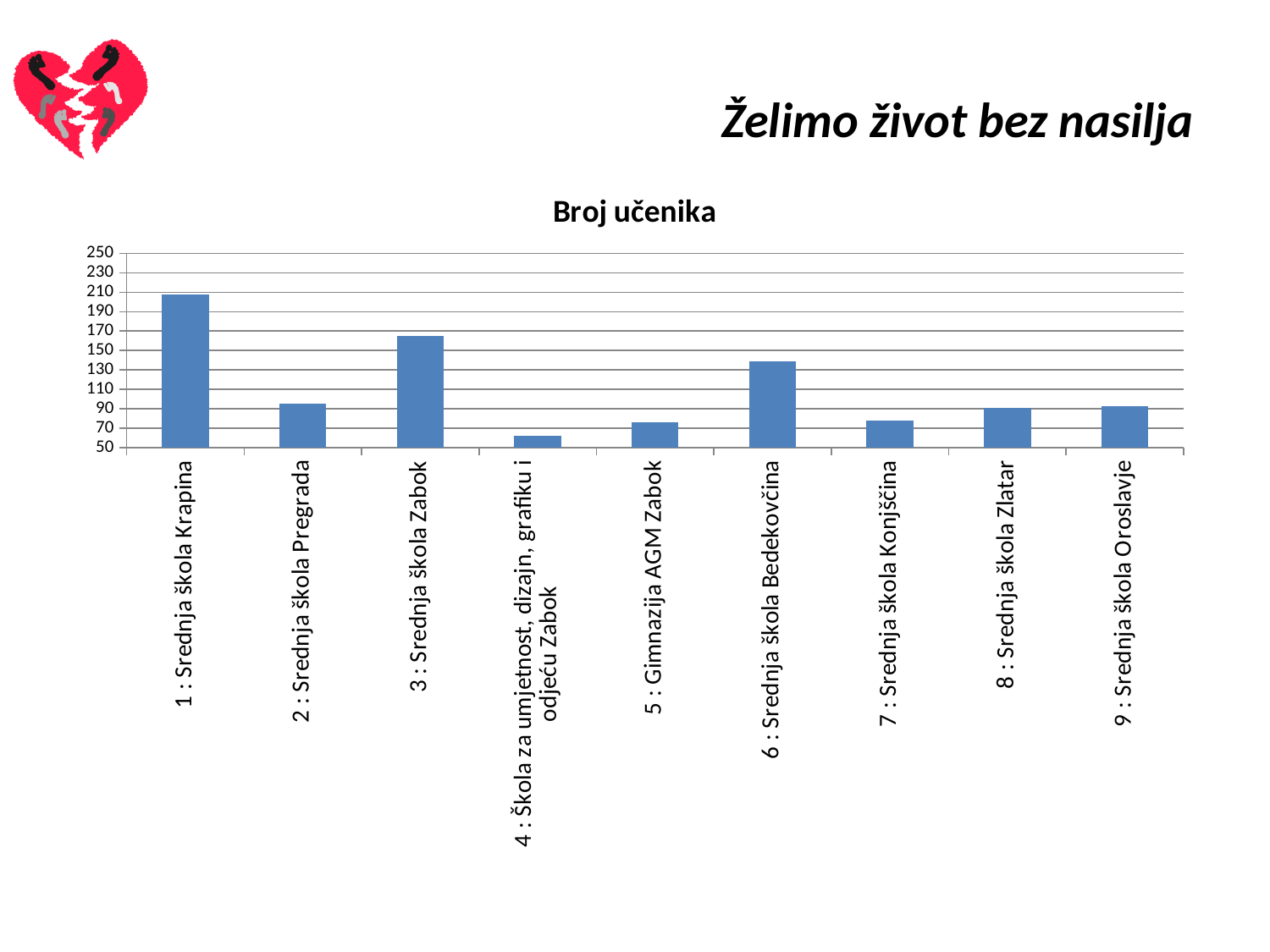
Is the value for 1 : Srednja škola Krapina greater or less than 190? greater What is the title of the chart? Broj učenika What kind of chart is shown on the slide? bar chart Is the value for 6 : Srednja škola Bedekovčina greater or less than 110? greater How many schools (categories) are shown on the x axis of the chart? 9 Is the value for 5 : Gimnazija AGM Zabok greater or less than 90? less Which school has the lowest number of students in the chart? 4 : Škola za umjetnost, dizajn, grafiku i odjeću Zabok Which school has the highest number of students in the chart? 1 : Srednja škola Krapina Which has more students, 6 : Srednja škola Bedekovčina or 2 : Srednja škola Pregrada? 6 : Srednja škola Bedekovčina Which has more students, 3 : Srednja škola Zabok or 6 : Srednja škola Bedekovčina? 3 : Srednja škola Zabok